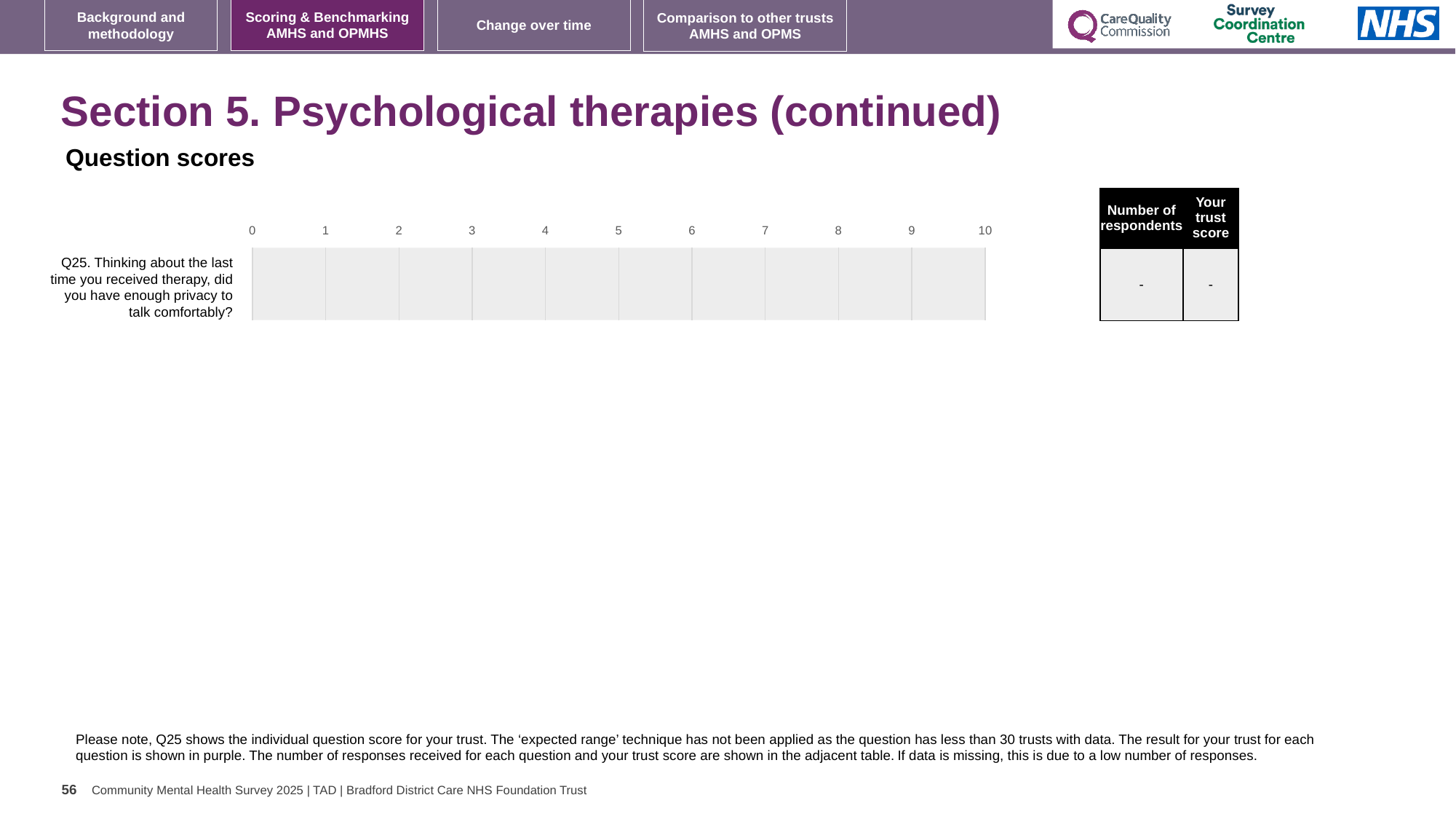
What is the 'Your trust score' value shown for Q25 in the table next to the chart? - How many questions are listed on the chart's vertical axis? 1 What is the minimum value shown on the chart's horizontal axis? 0 What is the maximum value shown on the chart's horizontal axis? 10 What is the 'Number of respondents' value shown for Q25 in the table next to the chart? - Is a bar plotted for Q25 on the chart? No